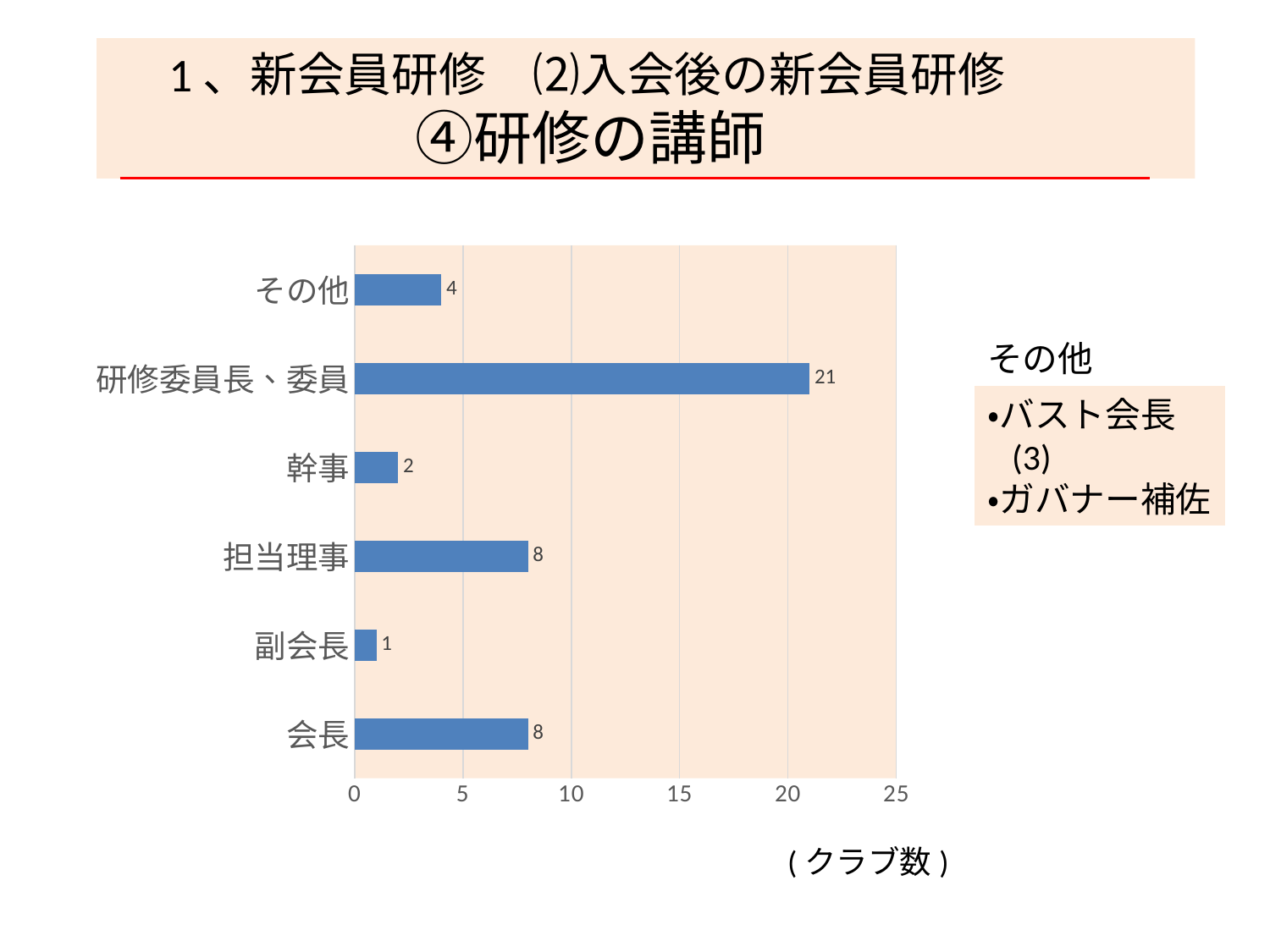
What is the value for 研修委員長、委員? 21 What is the value for 担当理事? 8 Is the value for 研修委員長、委員 greater or less than 20? greater What is the maximum value shown on the horizontal axis? 25 Which category has the highest value? 研修委員長、委員 Which category has the lowest value? 副会長 What is the value for 副会長? 1 How many categories are shown in the chart? 6 What kind of chart is shown on the slide? bar chart What is the value for その他? 4 What is the difference between the values for 研修委員長、委員 and 会長? 13 Which is larger, the value for 幹事 or the value for その他? その他